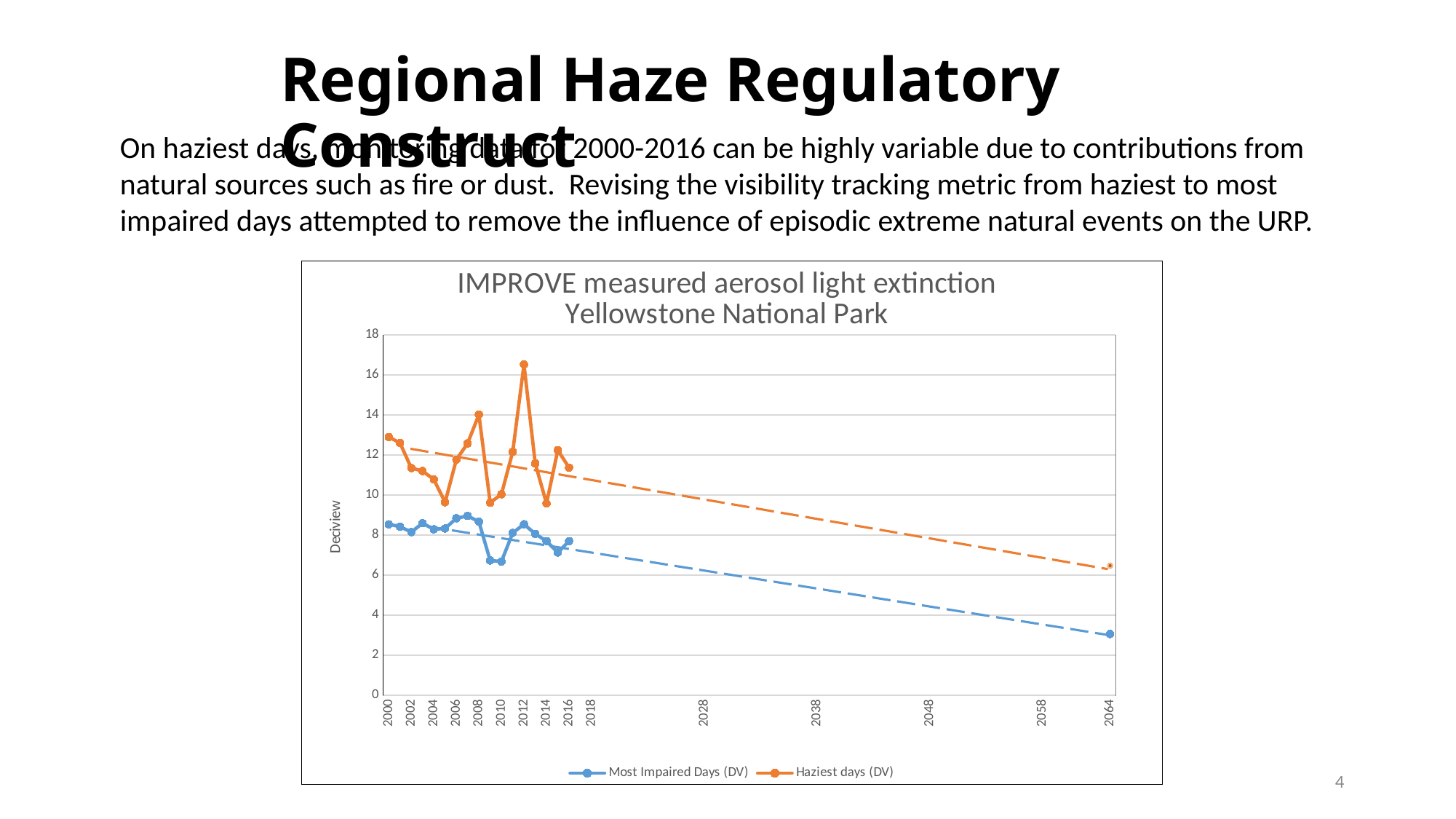
What are the two series named in the chart legend? Most Impaired Days (DV) and Haziest days (DV) How many series does the chart legend list? 2 What is the label on the vertical axis of the chart? Deciview Is the Most Impaired Days (DV) value for 2000 greater or less than 8? greater Do the dashed projection lines for both series rise or fall from 2016 to 2064? fall Is the Haziest days (DV) value for 2012 greater or less than 16? greater Which series is plotted higher on the chart throughout 2000-2016? Haziest days (DV) In which year does the Haziest days (DV) series reach its highest value? 2012 In 2012, which series has the larger value, Most Impaired Days (DV) or Haziest days (DV)? Haziest days (DV) Is the Most Impaired Days (DV) value for 2064 greater or less than 4? less What kind of chart is shown on the slide? line chart